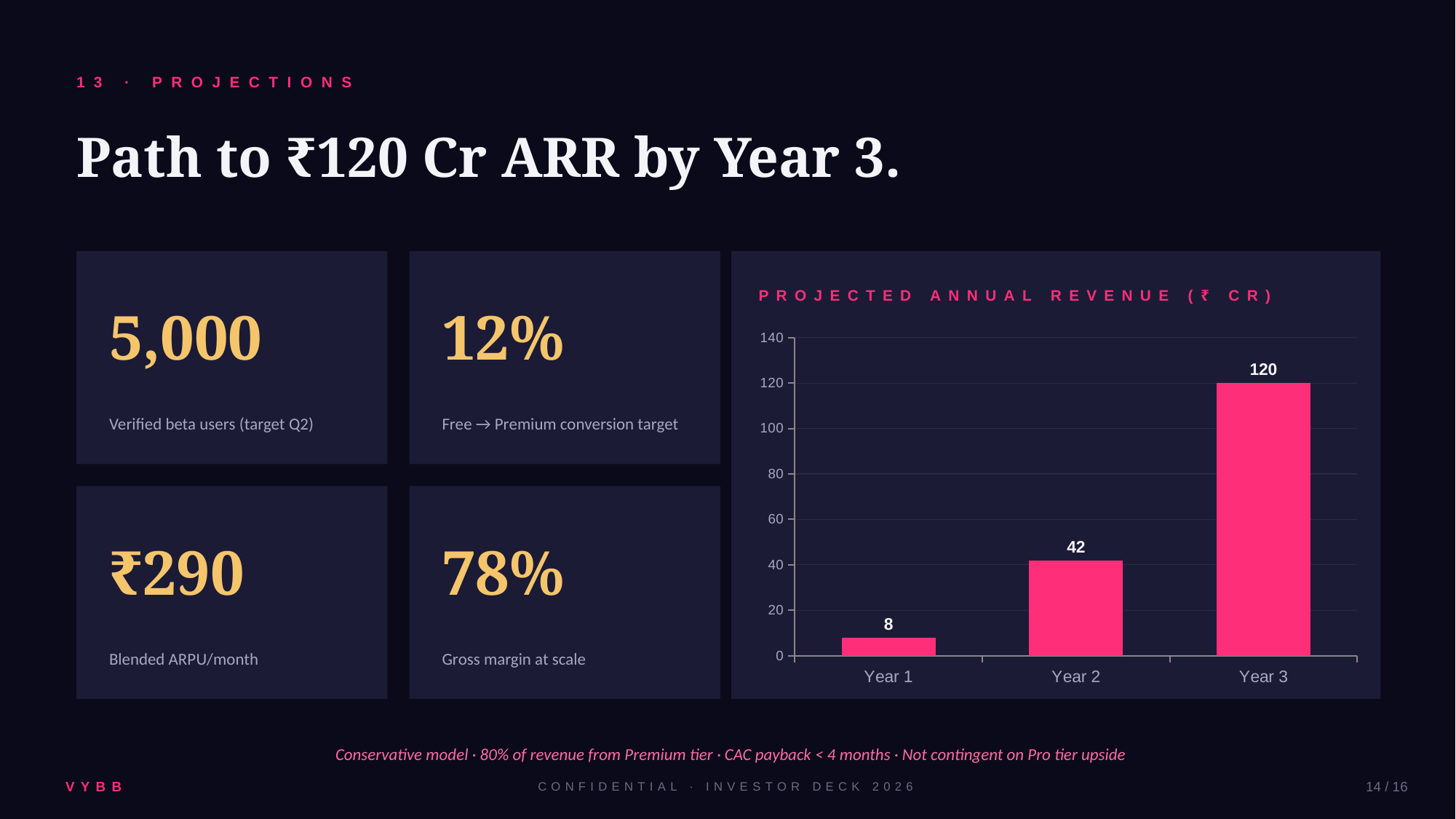
How many years are shown on the chart? 3 What is the projected annual revenue for Year 2? 42 What is the difference in projected annual revenue between Year 2 and Year 1? 34 What is the difference in projected annual revenue between Year 3 and Year 2? 78 Is the projected annual revenue for Year 2 greater or less than 60? less Which has a larger projected annual revenue, Year 1 or Year 2? Year 2 Which year has the highest projected annual revenue? Year 3 Which year has the lowest projected annual revenue? Year 1 What is the projected annual revenue for Year 1? 8 Does the projected annual revenue rise or fall from Year 1 to Year 3? Rise What is the projected annual revenue for Year 3? 120 What kind of chart is used to show projected annual revenue? Bar chart